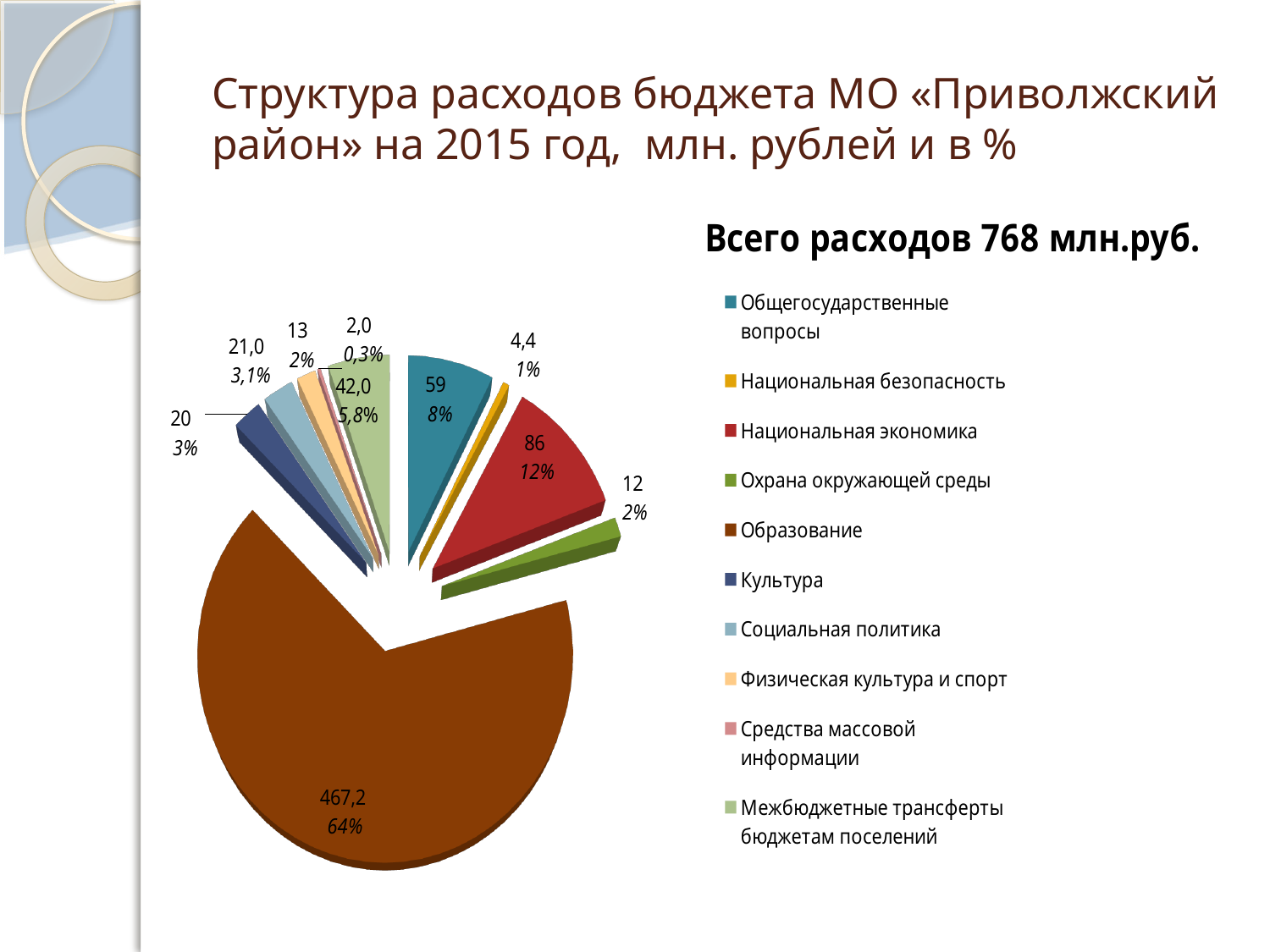
Which category has the largest slice of the pie? Образование What is the value for Межбюджетные трансферты бюджетам поселений? 42,0 How many categories does the legend list? 10 What kind of chart is shown on the slide? pie chart What share of the pie does Образование account for? 64% What is the value for Образование in the pie chart? 467,2 What is the title shown above the legend of the chart? Всего расходов 768 млн.руб. What is the difference between the values for Национальная экономика and Общегосударственные вопросы? 27 Which is larger, Национальная экономика or Общегосударственные вопросы? Национальная экономика What is the value for Национальная экономика? 86 Which category has the smallest slice of the pie? Средства массовой информации What percentage is shown for Общегосударственные вопросы? 8%